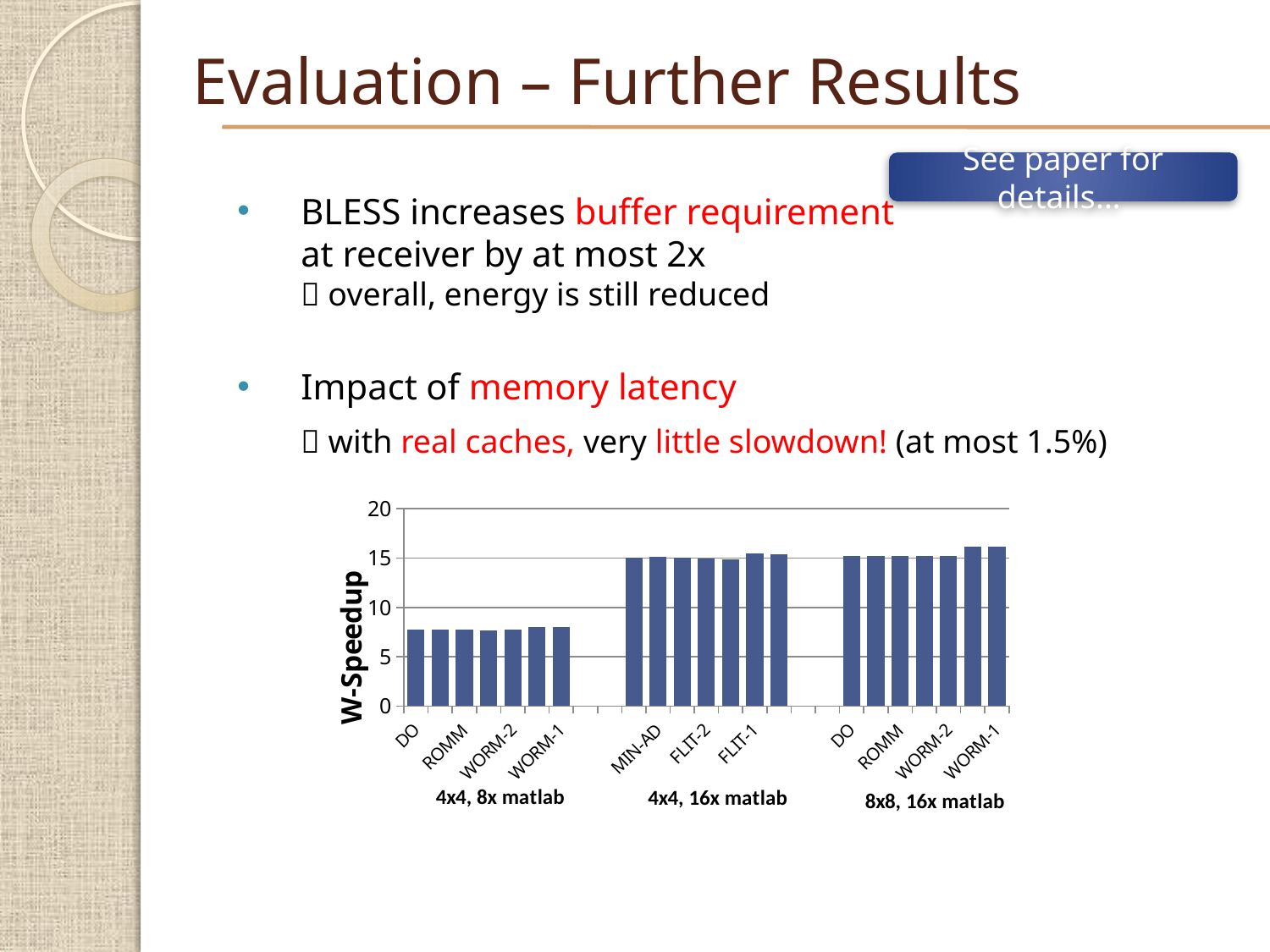
How many configuration groups (labelled below the x axis) does the chart show? 3 Is the value for DO in the 4x4, 8x matlab group greater or less than 5? greater Is the value for WORM-1 in the 8x8, 16x matlab group greater or less than 15? greater Is the value for MIN-AD in the 4x4, 16x matlab group greater or less than 10? greater What is the label of the vertical axis of the chart? W-Speedup Which is larger: the value for WORM-1 in the 4x4, 8x matlab group or the value for MIN-AD in the 4x4, 16x matlab group? MIN-AD in the 4x4, 16x matlab group Which configuration group has the lowest bars in the chart? 4x4, 8x matlab Which is larger: the value for DO in the 4x4, 8x matlab group or the value for DO in the 8x8, 16x matlab group? DO in the 8x8, 16x matlab group What kind of chart is shown on the slide? bar chart How many bars are in the 4x4, 8x matlab group? 7 Which configuration group contains the tallest bar in the chart? 8x8, 16x matlab